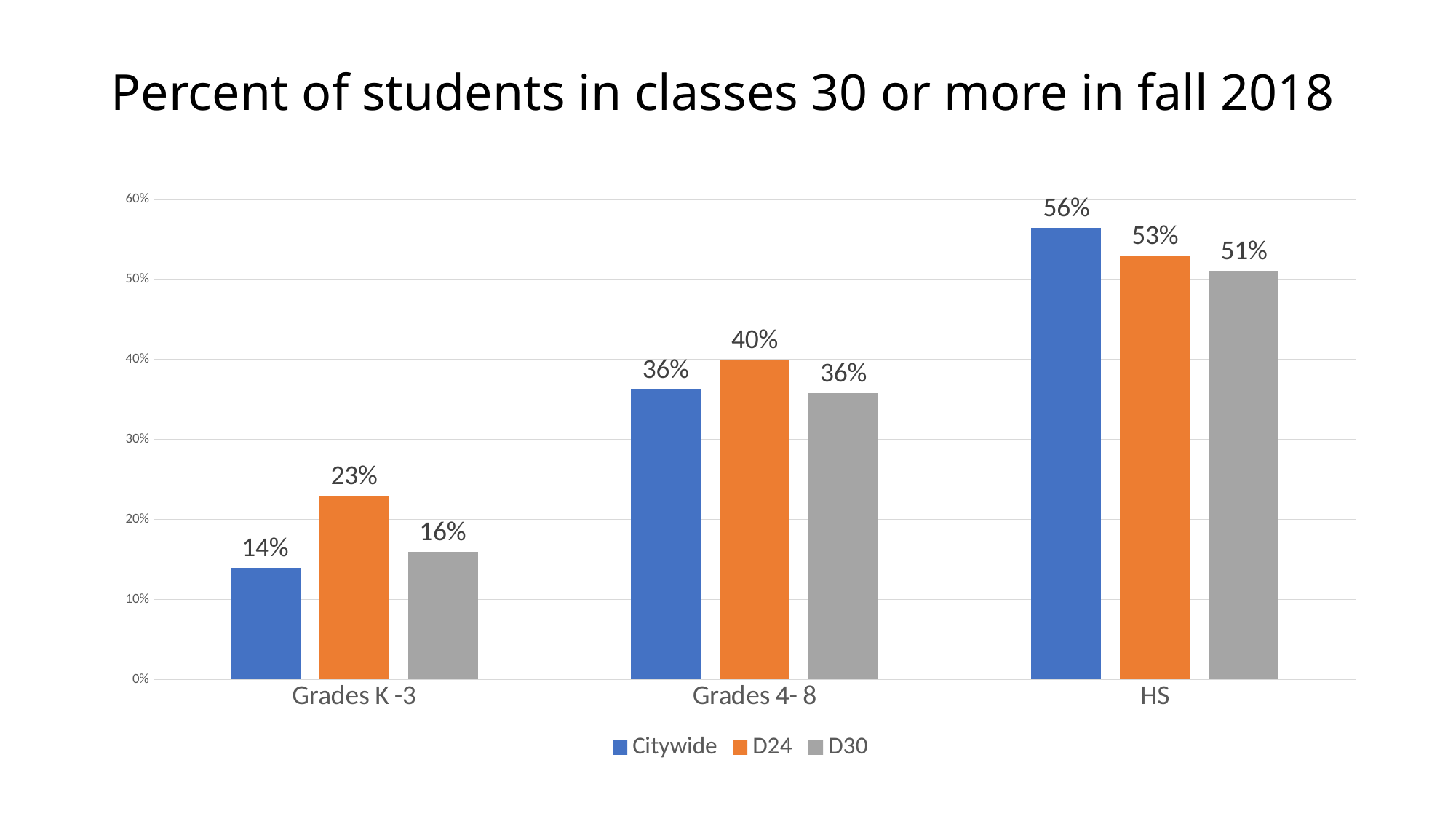
Which grade group has the lowest D24 value? Grades K -3 How many grade groups are shown on the x axis? 3 Which is larger for HS, the Citywide value or the D24 value? Citywide What kind of chart is shown on the slide? Bar chart What is the difference between the D24 and Citywide values for Grades K -3? 9% What is the D24 value for Grades 4- 8? 40% Is the D30 value for Grades 4- 8 greater or less than 30%? greater Which grade group has the highest Citywide value? HS Do the Citywide values rise or fall from Grades K -3 to HS? Rise What is the Citywide value for Grades K -3? 14% What is the D30 value for HS? 51% How many series does the legend list? 3